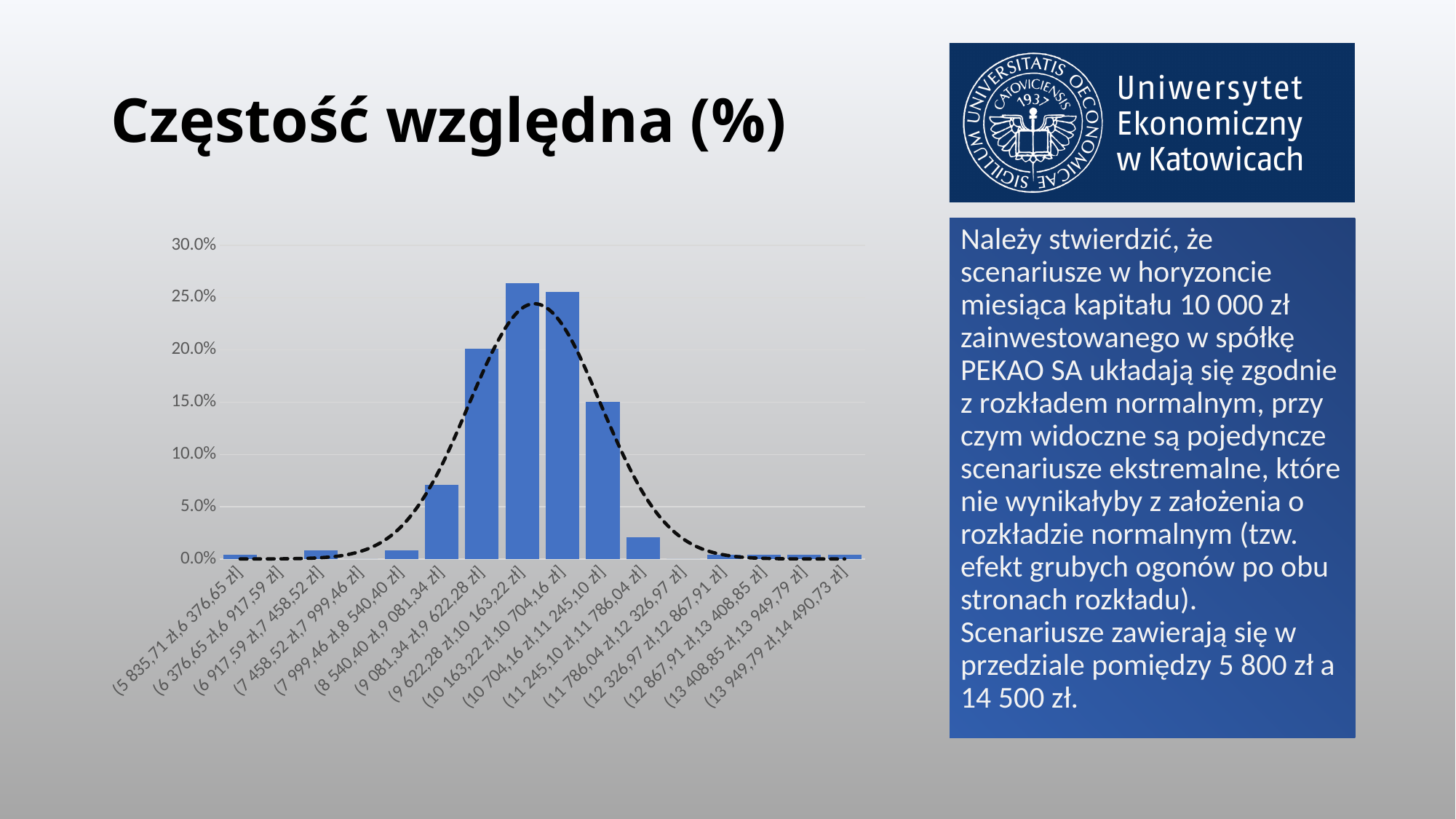
What is the title of the chart on the slide? Częstość względna (%) Is the value for the interval (8 540,40 zł; 9 081,34 zł] greater or less than 10.0%? less What is the highest tick value shown on the y axis of the chart? 30.0% Which is larger: the value for (8 540,40 zł; 9 081,34 zł] or the value for (11 245,10 zł; 11 786,04 zł]? (8 540,40 zł; 9 081,34 zł] Which interval has the highest bar in the chart? (9 622,28 zł; 10 163,22 zł] Is the value for the interval (9 622,28 zł; 10 163,22 zł] greater or less than 25.0%? greater Is the value for the interval (9 081,34 zł; 9 622,28 zł] greater or less than 15.0%? greater What kind of chart is shown on the slide? combination bar and line chart (bars with a dashed line) How many categories (intervals) are shown on the x axis of the chart? 16